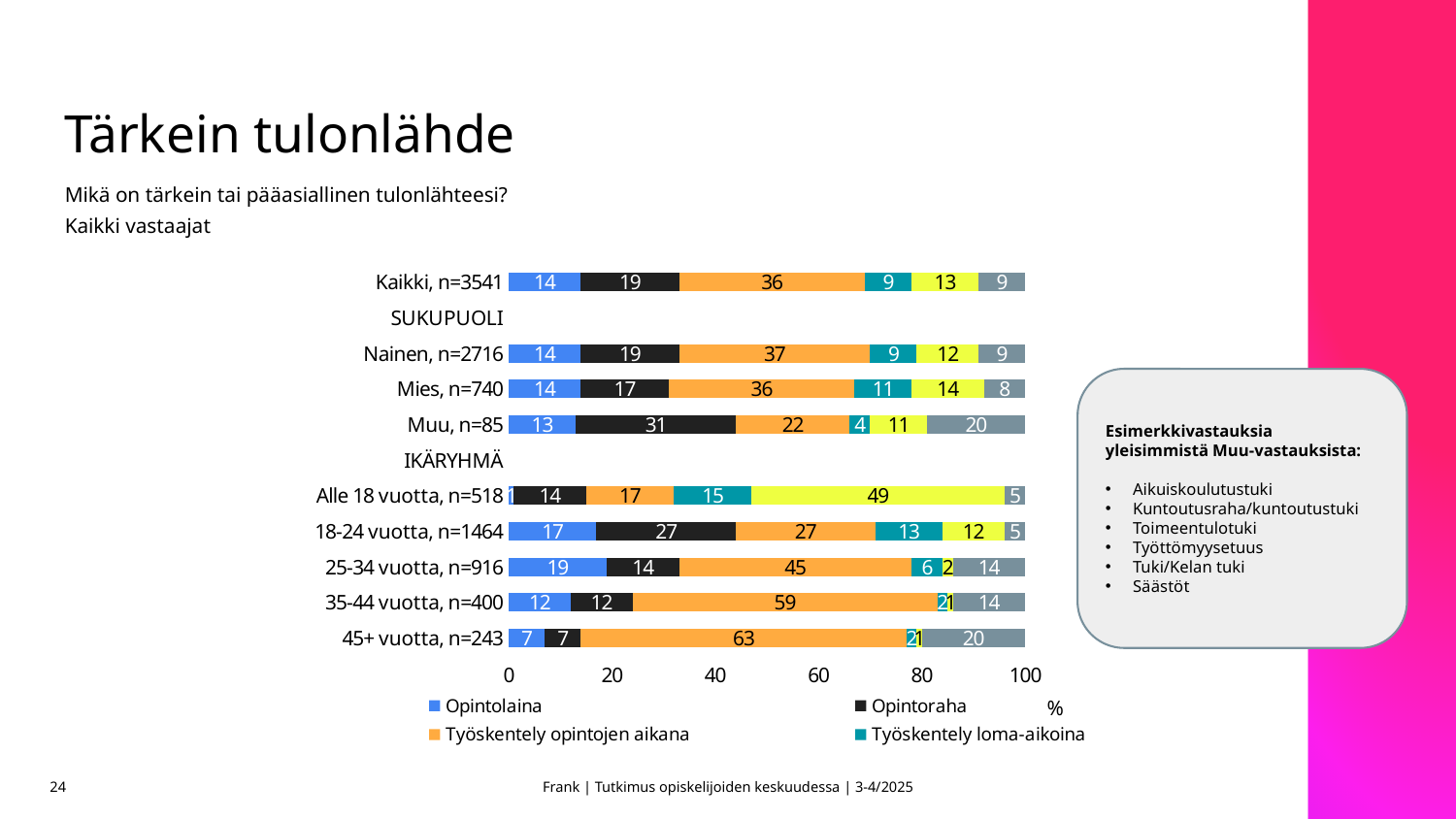
Which category has the lowest Opintolaina value? Alle 18 vuotta, n=518 How many series does the legend list? 4 What kind of chart is shown on the slide? Stacked bar chart What is the Opintolaina value for 25-34 vuotta, n=916? 19 What is the Opintoraha value for Muu, n=85? 31 Which has the larger Työskentely loma-aikoina value, Mies, n=740 or Nainen, n=2716? Mies, n=740 What is the difference between the Opintoraha values for 18-24 vuotta, n=1464 and 25-34 vuotta, n=916? 13 What is the value for Työskentely opintojen aikana in the 45+ vuotta, n=243 bar? 63 What is the Opintoraha value for Kaikki, n=3541? 19 How many bars (respondent groups) are plotted in the chart? 9 What is the difference between the Työskentely opintojen aikana values for 35-44 vuotta, n=400 and 18-24 vuotta, n=1464? 32 Which category has the highest value for Työskentely opintojen aikana? 45+ vuotta, n=243